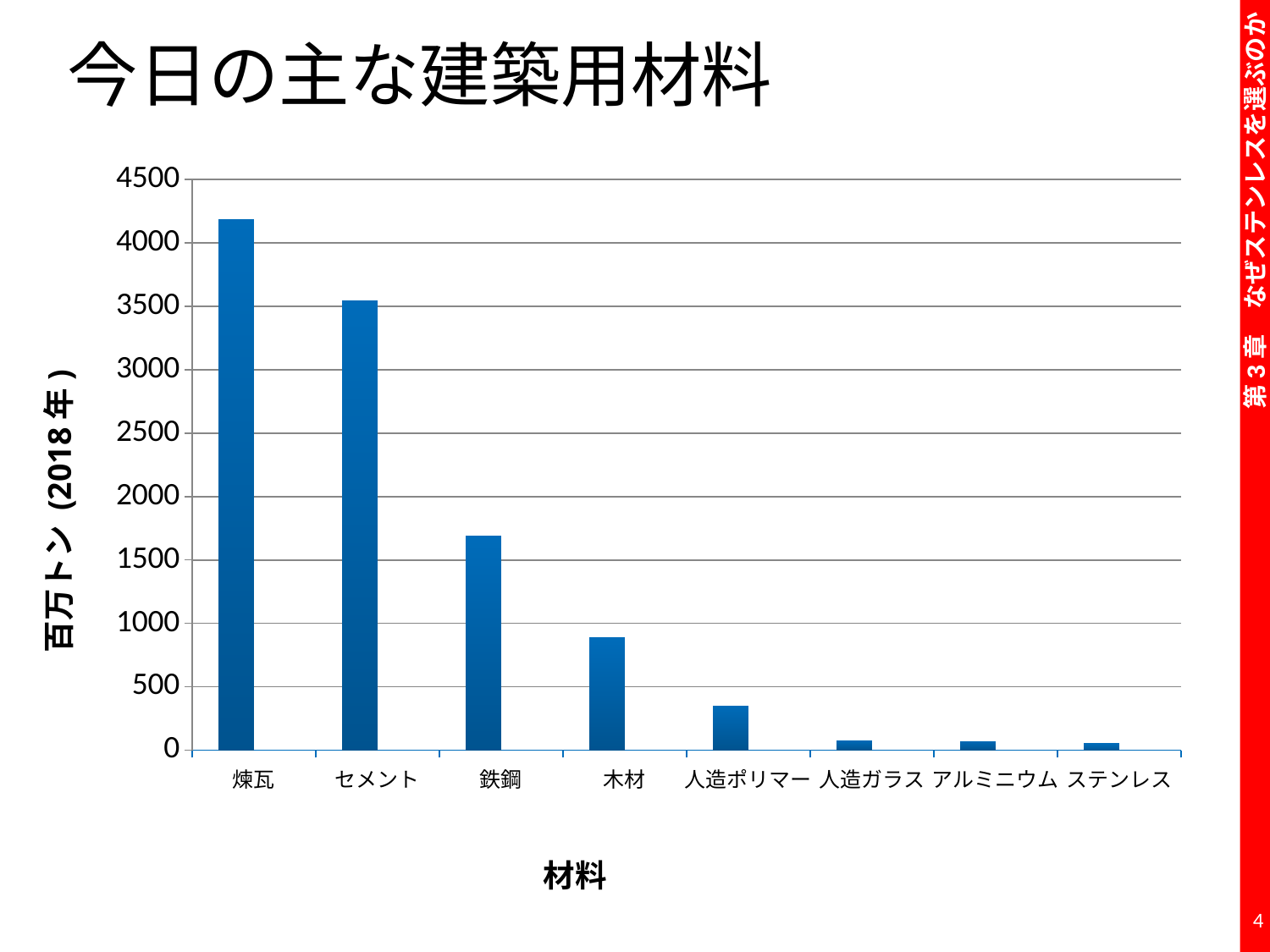
Which is larger, the value for 木材 or the value for 人造ポリマー? 木材 What is the title of the vertical axis? 百万トン (2018年) What kind of chart is shown on the slide? bar chart Which material has the highest value? 煉瓦 How many materials (categories) are plotted on the x axis? 8 Is the value for 煉瓦 greater or less than 4000? greater Is the value for 鉄鋼 greater or less than 1500? greater Is the value for 人造ポリマー greater or less than 500? less Which is larger, the value for 煉瓦 or the value for セメント? 煉瓦 Do the values rise or fall moving from left to right along the x axis? fall